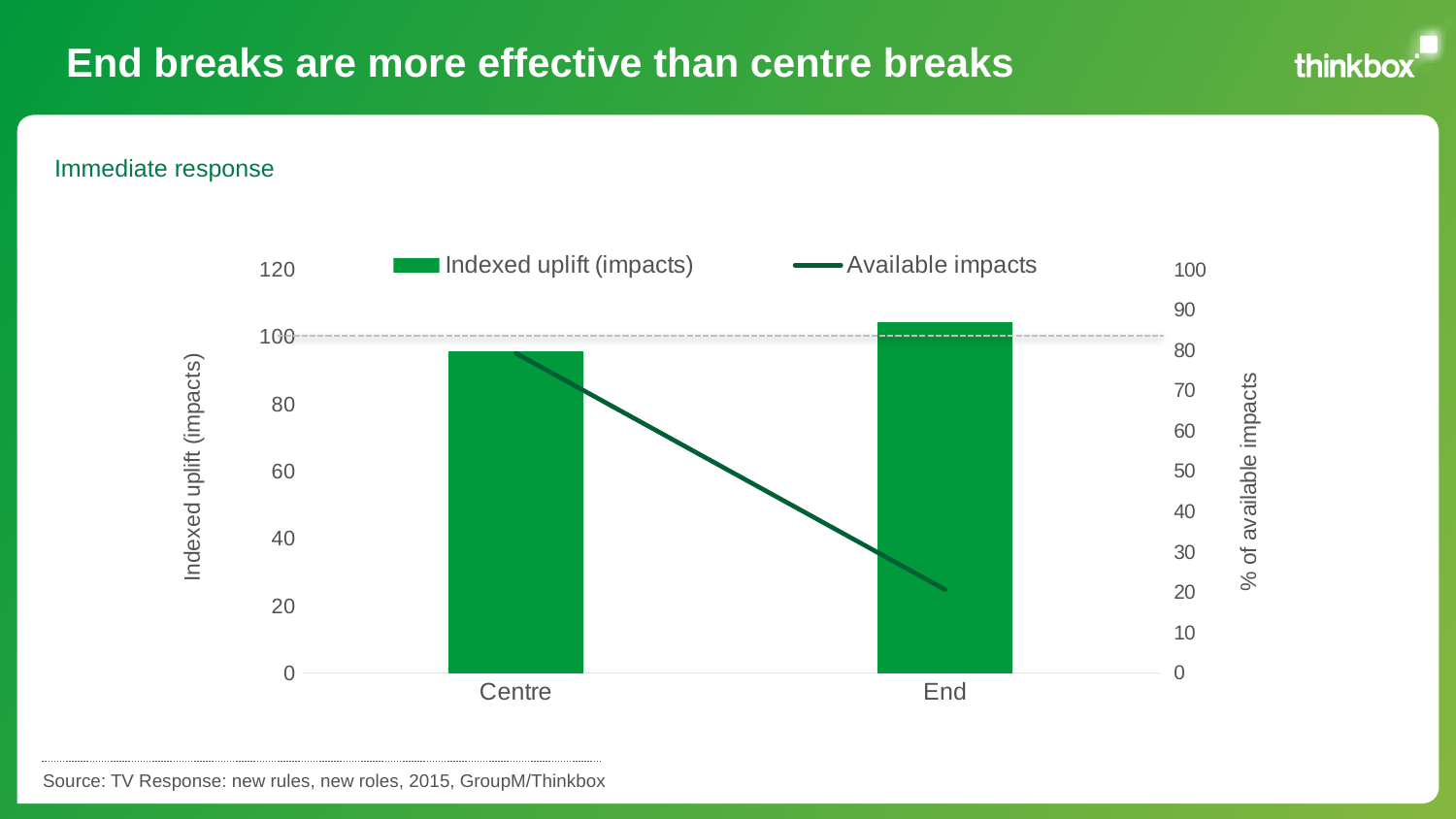
Which category has the higher Available impacts value, Centre or End? Centre Is the Indexed uplift (impacts) value for Centre greater or less than 80? greater Which category has the higher Indexed uplift (impacts) bar? End Is the Indexed uplift (impacts) value for Centre greater or less than 100? less What is the label of the right-hand vertical axis? % of available impacts Is the Available impacts value for End greater or less than 30 on the right axis? less How many series does the legend list? 2 Does the Available impacts line rise or fall from Centre to End? Fall How many categories are shown on the x axis? 2 What kind of chart is shown on the slide? A bar chart combined with a line Which category has the lower Indexed uplift (impacts) bar? Centre